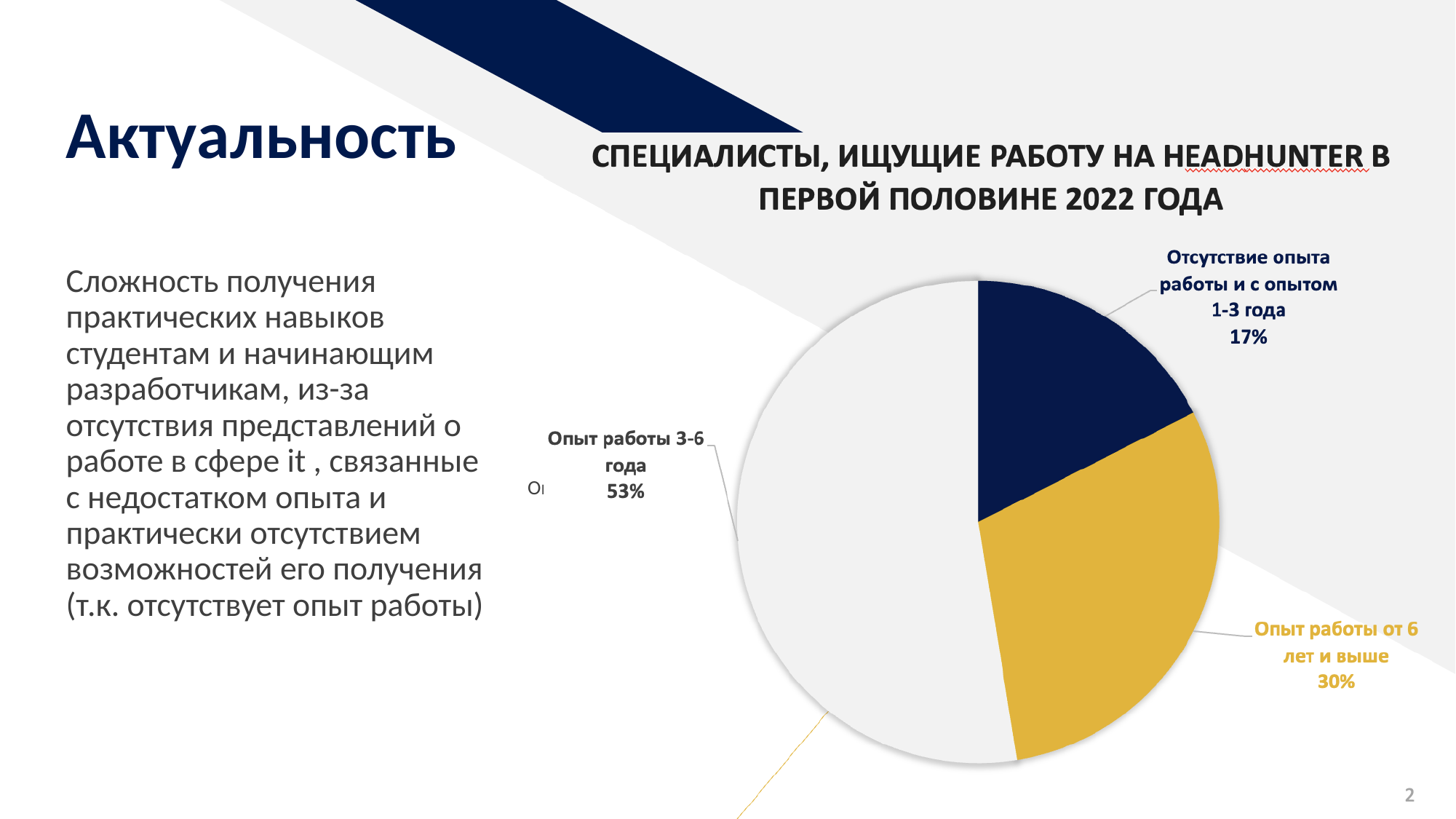
What share of the pie is labelled "Опыт работы от 6 лет и выше"? 30% What colour is the "Опыт работы от 6 лет и выше" slice? yellow What is the difference in percentage points between the "Опыт работы от 6 лет и выше" slice and the "Отсутствие опыта работы и с опытом 1-3 года" slice? 13 Which slice of the pie is the largest? Опыт работы 3-6 года What share of the pie is labelled "Опыт работы 3-6 года"? 53% What share of the pie is labelled "Отсутствие опыта работы и с опытом 1-3 года"? 17% Which is larger: the "Опыт работы от 6 лет и выше" slice or the "Отсутствие опыта работы и с опытом 1-3 года" slice? Опыт работы от 6 лет и выше What is the title of the chart? СПЕЦИАЛИСТЫ, ИЩУЩИЕ РАБОТУ НА HEADHUNTER В ПЕРВОЙ ПОЛОВИНЕ 2022 ГОДА Which slice of the pie is the smallest? Отсутствие опыта работы и с опытом 1-3 года How many slices does the pie chart have? 3 What kind of chart is shown on the slide? pie chart What is the difference in percentage points between the "Опыт работы 3-6 года" slice and the "Опыт работы от 6 лет и выше" slice? 23